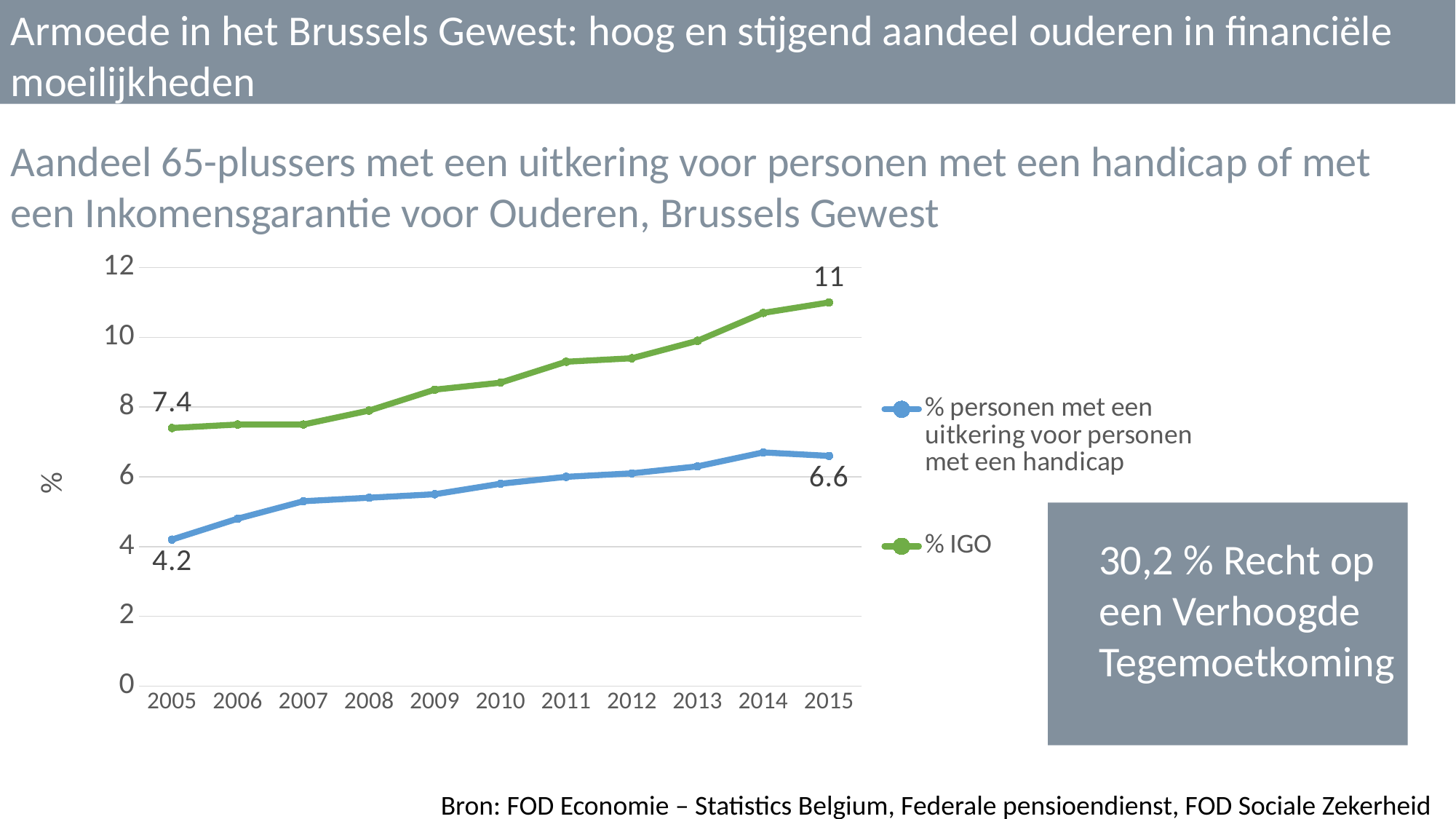
Is the value for % personen met een uitkering voor personen met een handicap in 2008 greater or less than 6? less Does the % IGO series rise or fall from 2005 to 2015? rise What is the value of % IGO in 2005? 7.4 How many series does the legend list? 2 By how much did % personen met een uitkering voor personen met een handicap increase from 2005 to 2015? 2.4 How many years are shown on the x axis? 11 What is the value of % IGO in 2015? 11 In 2015, which series has the higher value: % IGO or % personen met een uitkering voor personen met een handicap? % IGO What is the value of % personen met een uitkering voor personen met een handicap in 2015? 6.6 What kind of chart is shown on the slide? line chart What is the value of % personen met een uitkering voor personen met een handicap in 2005? 4.2 By how much did % IGO increase from 2005 to 2015? 3.6